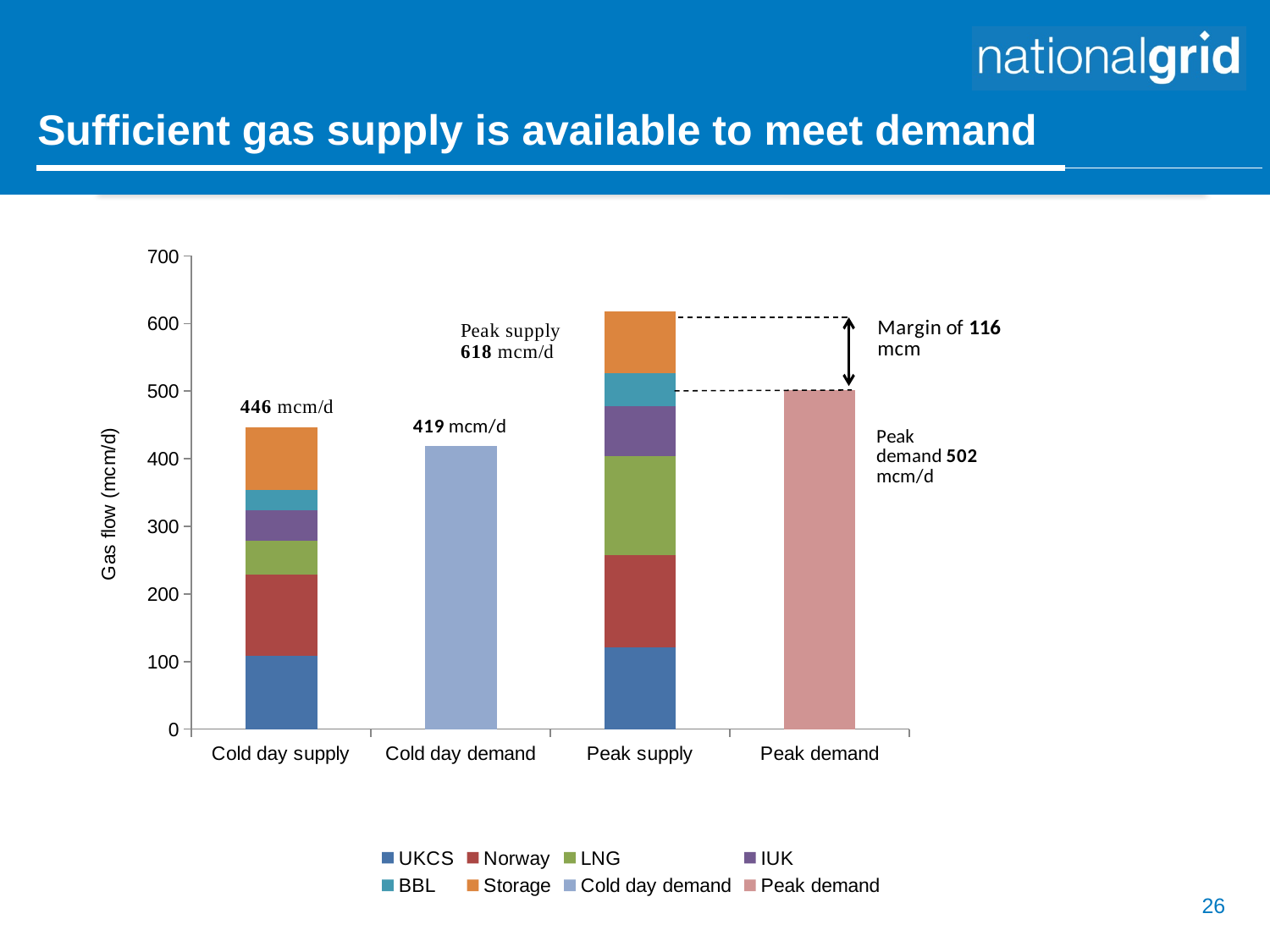
Which category has the highest total value? Peak supply Which is larger, Cold day supply or Peak demand? Peak demand How many series does the legend list? 8 Which category has the lowest total value? Cold day demand What is the value for Cold day demand? 419 mcm/d What is the value for Peak demand? 502 mcm/d What kind of chart is shown on the slide? Stacked bar chart How many categories are shown on the x axis? 4 What is the difference between Cold day supply and Cold day demand? 27 mcm/d What is the total for the Cold day supply bar? 446 mcm/d What is the total for the Peak supply bar? 618 mcm/d What is the difference between Peak supply and Peak demand? 116 mcm